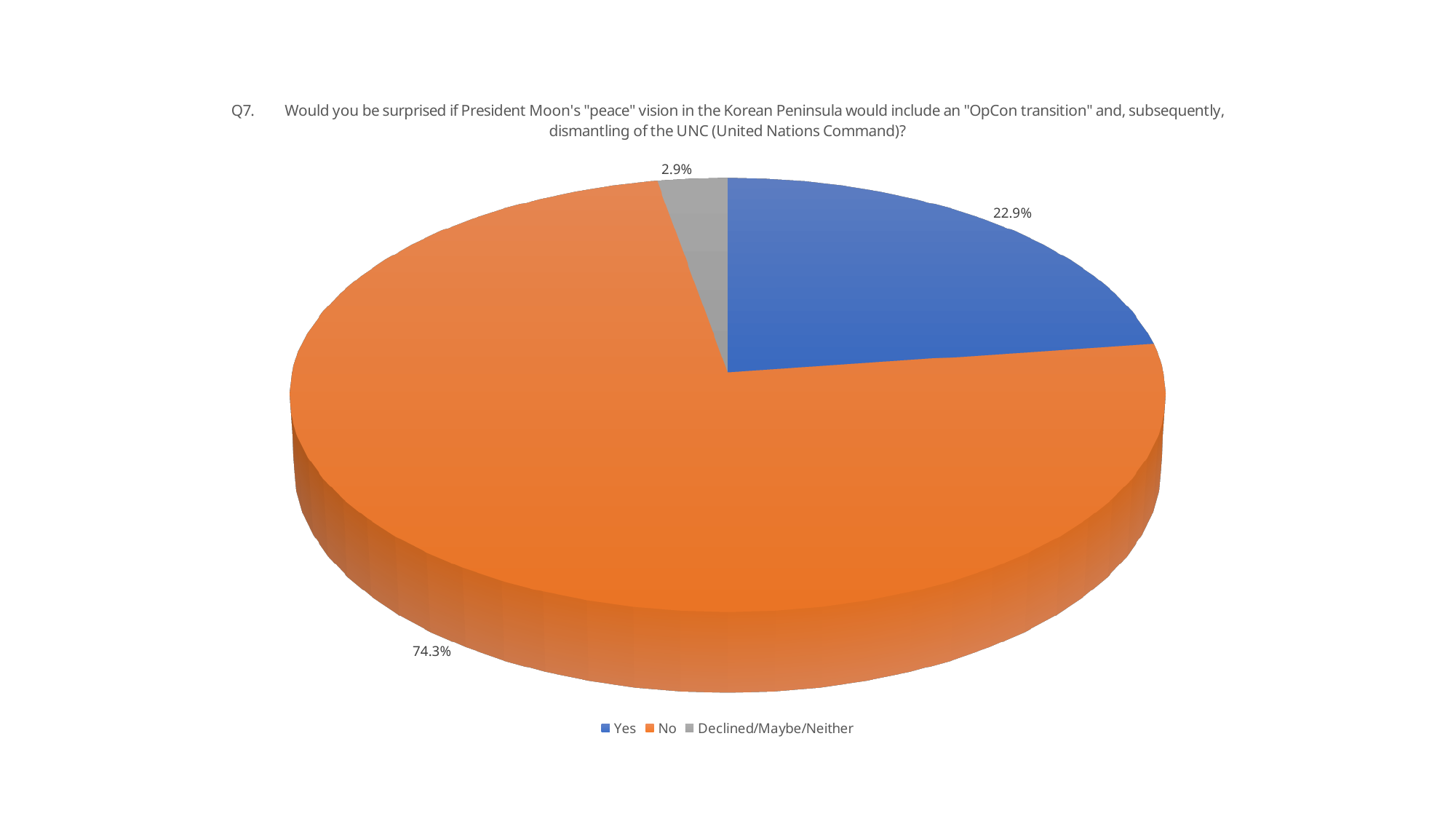
What percentage of respondents answered "No"? 74.3% What is the difference in percentage points between the "No" and "Yes" slices? 51.4 How many entries does the legend list? 3 Which is larger, the "Yes" slice or the "Declined/Maybe/Neither" slice? Yes What colour is the "No" slice? Orange Which response has the smallest share of the pie? Declined/Maybe/Neither What type of chart is shown on the slide? Pie chart Which response has the largest share of the pie? No What percentage of respondents fall under "Declined/Maybe/Neither"? 2.9% What percentage of respondents answered "Yes"? 22.9% What colour is the "Yes" slice? Blue How many slices does the pie chart have? 3